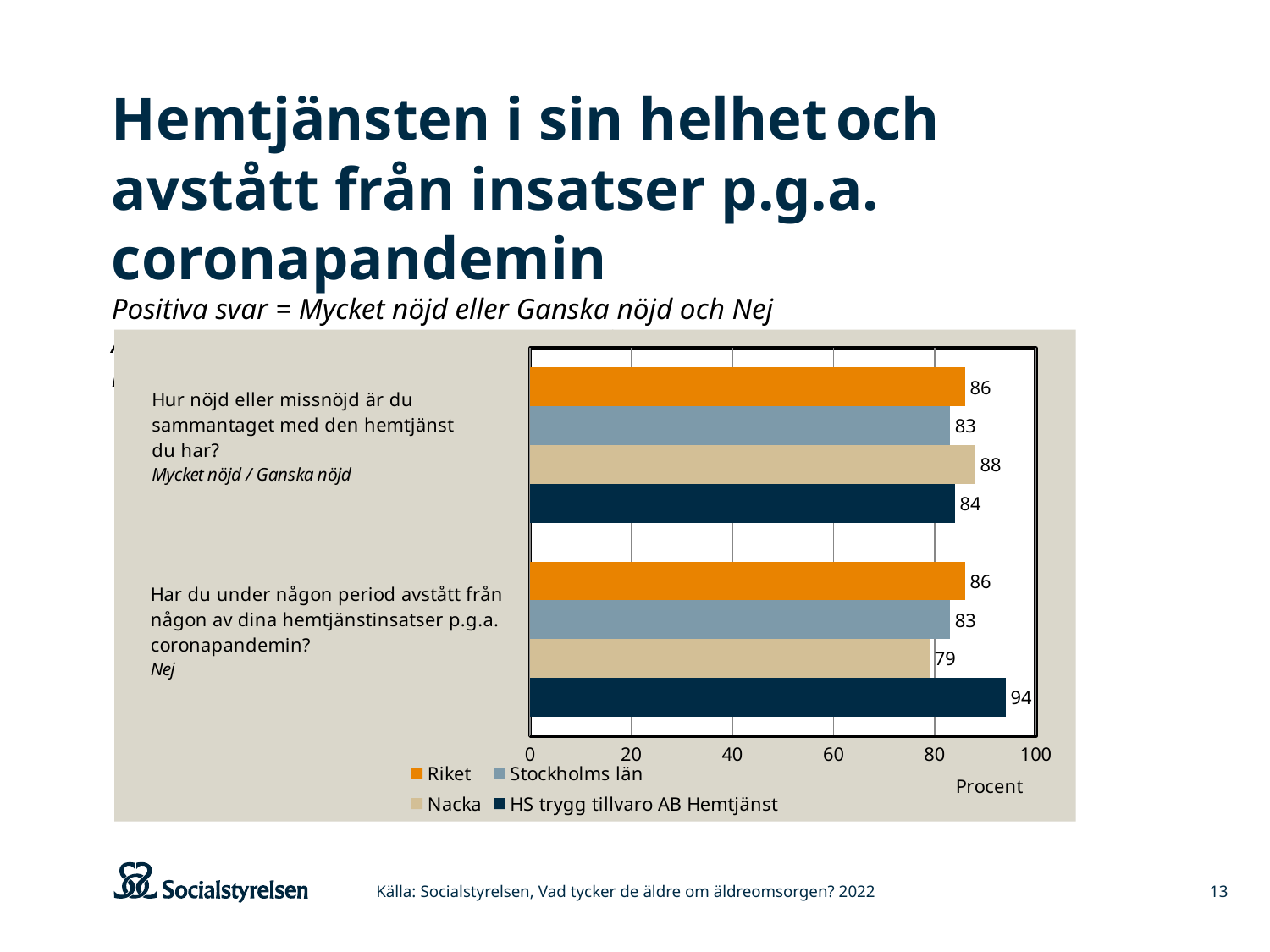
Which is larger on the question "Hur nöjd eller missnöjd är du sammantaget med den hemtjänst du har?": Riket or HS trygg tillvaro AB Hemtjänst? Riket How many questions (categories) are shown on the chart? 2 What is the value for Riket on the question "Har du under någon period avstått från någon av dina hemtjänstinsatser p.g.a. coronapandemin?"? 86 What is the value for HS trygg tillvaro AB Hemtjänst on the question "Har du under någon period avstått från någon av dina hemtjänstinsatser p.g.a. coronapandemin?"? 94 Which series has the highest value on the question "Hur nöjd eller missnöjd är du sammantaget med den hemtjänst du har?"? Nacka What is the difference between HS trygg tillvaro AB Hemtjänst and Nacka on the question "Har du under någon period avstått från någon av dina hemtjänstinsatser p.g.a. coronapandemin?"? 15 What kind of chart is shown on the slide? Bar chart How many series does the legend list? 4 Which series has the lowest value on the question "Har du under någon period avstått från någon av dina hemtjänstinsatser p.g.a. coronapandemin?"? Nacka What is the value for Stockholms län on the question "Hur nöjd eller missnöjd är du sammantaget med den hemtjänst du har?"? 83 Which series has the highest value on the question "Har du under någon period avstått från någon av dina hemtjänstinsatser p.g.a. coronapandemin?"? HS trygg tillvaro AB Hemtjänst What is the value for Nacka on the question "Hur nöjd eller missnöjd är du sammantaget med den hemtjänst du har?"? 88